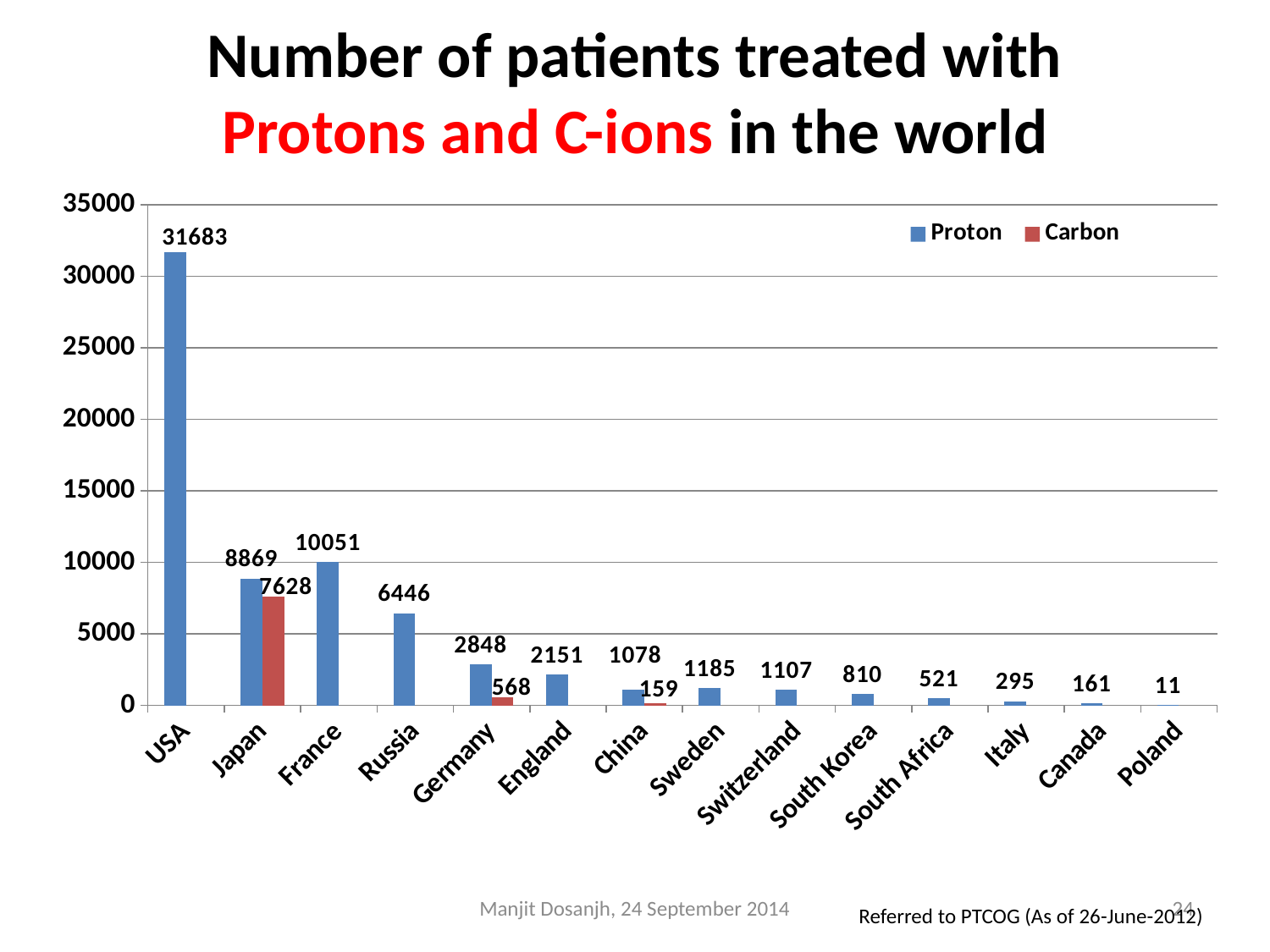
Which country has the highest number of proton patients? USA What is the number of patients treated with protons in the USA? 31683 Which is larger, the proton value for Sweden or for Switzerland? Sweden How many series does the legend list? 2 What is the proton value for France? 10051 What kind of chart is shown on the slide? bar chart What is the carbon value for Germany? 568 Which country has the lowest number of proton patients? Poland Is the proton value for Russia greater or less than 5000? greater How many countries are shown on the x axis? 14 What is the difference between the proton and carbon values for Japan? 1241 What is the number of patients treated with carbon ions in Japan? 7628